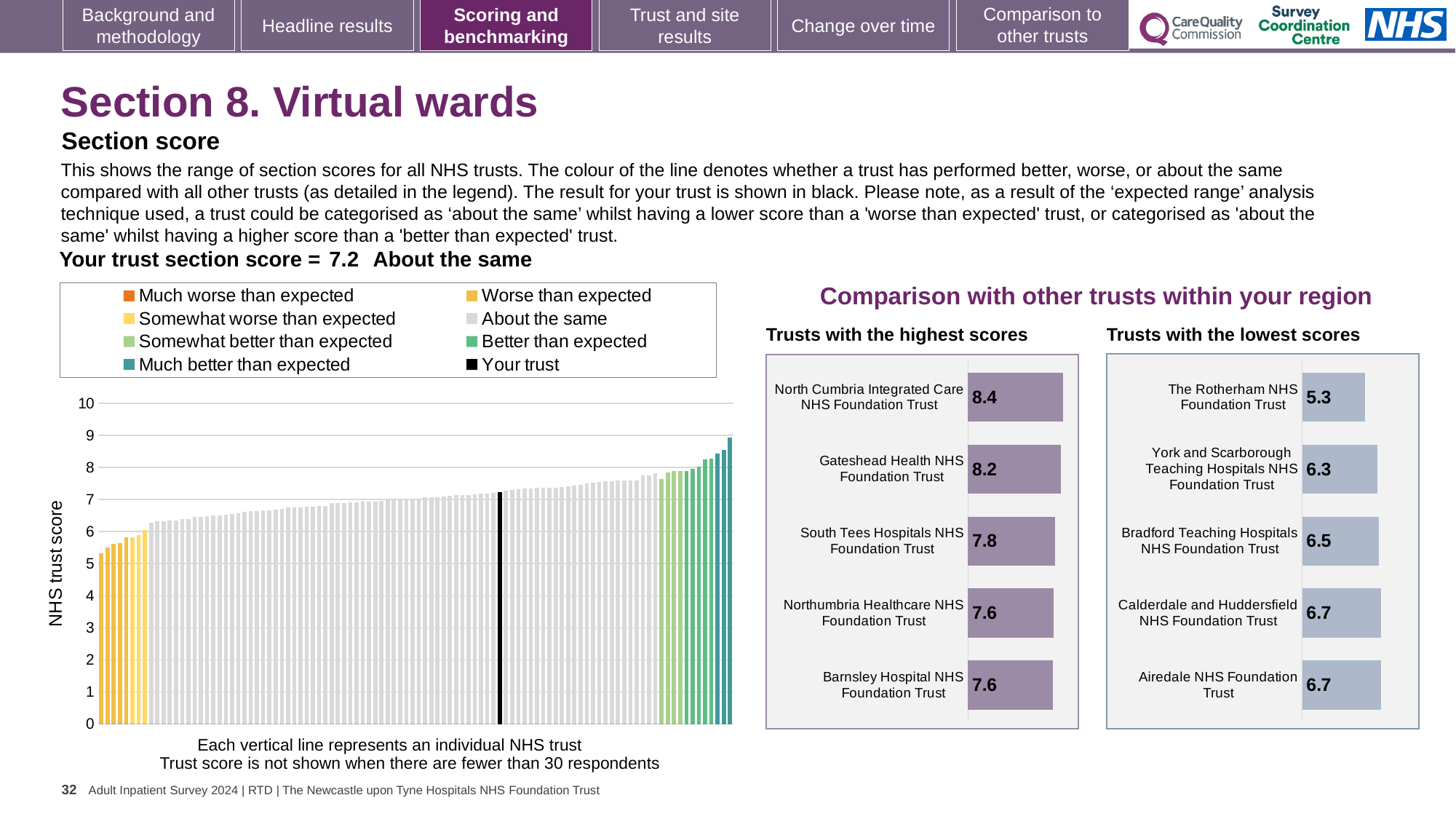
How many trusts are shown on the 'Trusts with the lowest scores' chart? 5 On the 'Trusts with the highest scores' chart, what is the score for North Cumbria Integrated Care NHS Foundation Trust? 8.4 On the 'Trusts with the lowest scores' chart, which has the larger score: York and Scarborough Teaching Hospitals NHS Foundation Trust or Bradford Teaching Hospitals NHS Foundation Trust? Bradford Teaching Hospitals NHS Foundation Trust On the 'Trusts with the highest scores' chart, which trust has the highest score? North Cumbria Integrated Care NHS Foundation Trust On the NHS trust score chart on the left, what is the section score for your trust (the black bar)? 7.2 How many entries does the legend of the NHS trust score chart on the left list? 8 What kind of chart is the NHS trust score chart on the left of the slide? Bar chart On the NHS trust score chart on the left, is the value of the tallest bar greater or less than 8? greater On the 'Trusts with the lowest scores' chart, which trust has the lowest score? The Rotherham NHS Foundation Trust On the 'Trusts with the lowest scores' chart, what is the score for The Rotherham NHS Foundation Trust? 5.3 On the 'Trusts with the highest scores' chart, what score is shown for Gateshead Health NHS Foundation Trust? 8.2 On the 'Trusts with the highest scores' chart, what is the difference between the scores of North Cumbria Integrated Care NHS Foundation Trust and South Tees Hospitals NHS Foundation Trust? 0.6